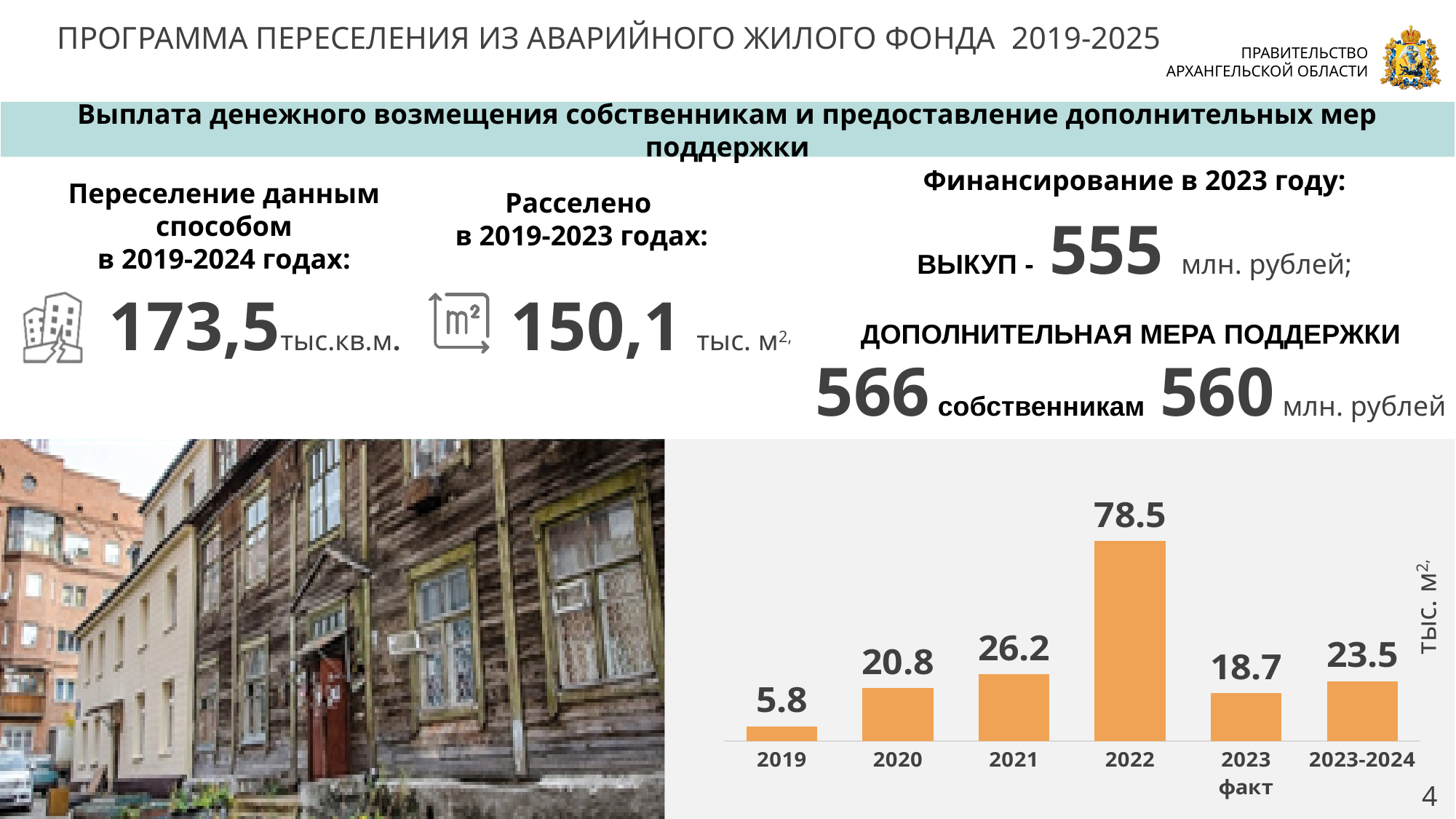
What is the value shown for the '2023 факт' bar on the chart? 18.7 How many bars are shown on the chart? 6 Which category has the highest value on the bar chart? 2022 Which category has the lowest value on the bar chart? 2019 What is the value shown for 2022 on the bar chart? 78.5 What is the value shown for 2019 on the bar chart? 5.8 What type of chart is shown on the slide? bar chart What is the difference between the values for 2020 and 2019 on the bar chart? 15.0 Which is larger on the bar chart, the value for 2021 or the value for 2023-2024? 2021 What is the value shown for 2023-2024 on the bar chart? 23.5 What unit is indicated on the vertical axis label of the bar chart? тыс. м² What is the difference between the values for 2022 and 2021 on the bar chart? 52.3